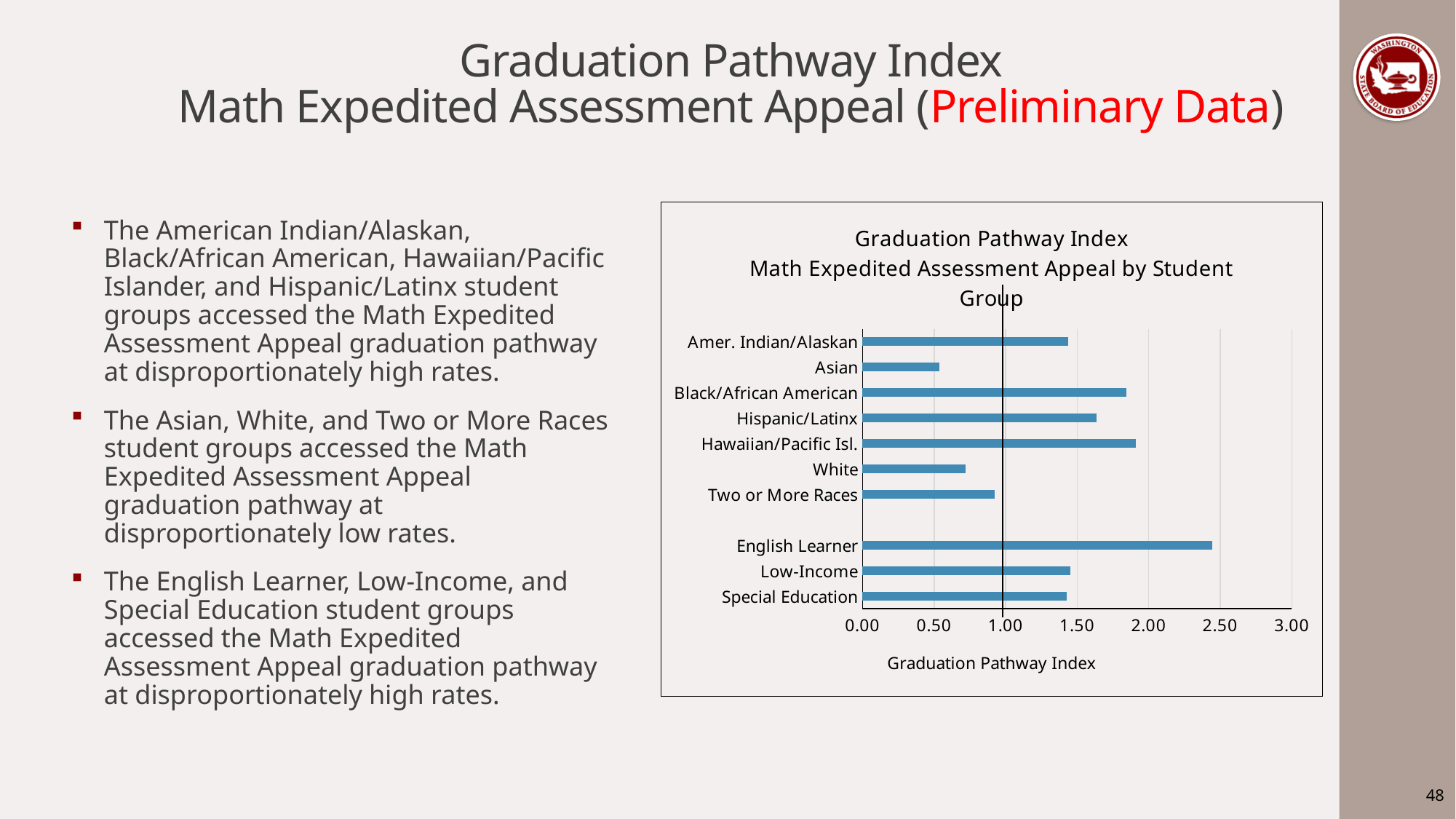
Is the Graduation Pathway Index for English Learner greater or less than 2.00? greater Which has a higher Graduation Pathway Index, Black/African American or Hispanic/Latinx? Black/African American What type of chart is shown on the slide? bar chart Is the Graduation Pathway Index for Hawaiian/Pacific Isl. greater or less than 1.50? greater How many student groups are plotted in the chart? 10 Is the Graduation Pathway Index for Hispanic/Latinx greater or less than 1.50? greater What is the title of the horizontal axis in the chart? Graduation Pathway Index Which student group has the lowest Graduation Pathway Index in the chart? Asian Which student group has the highest Graduation Pathway Index in the chart? English Learner Which has a higher Graduation Pathway Index, White or Two or More Races? Two or More Races